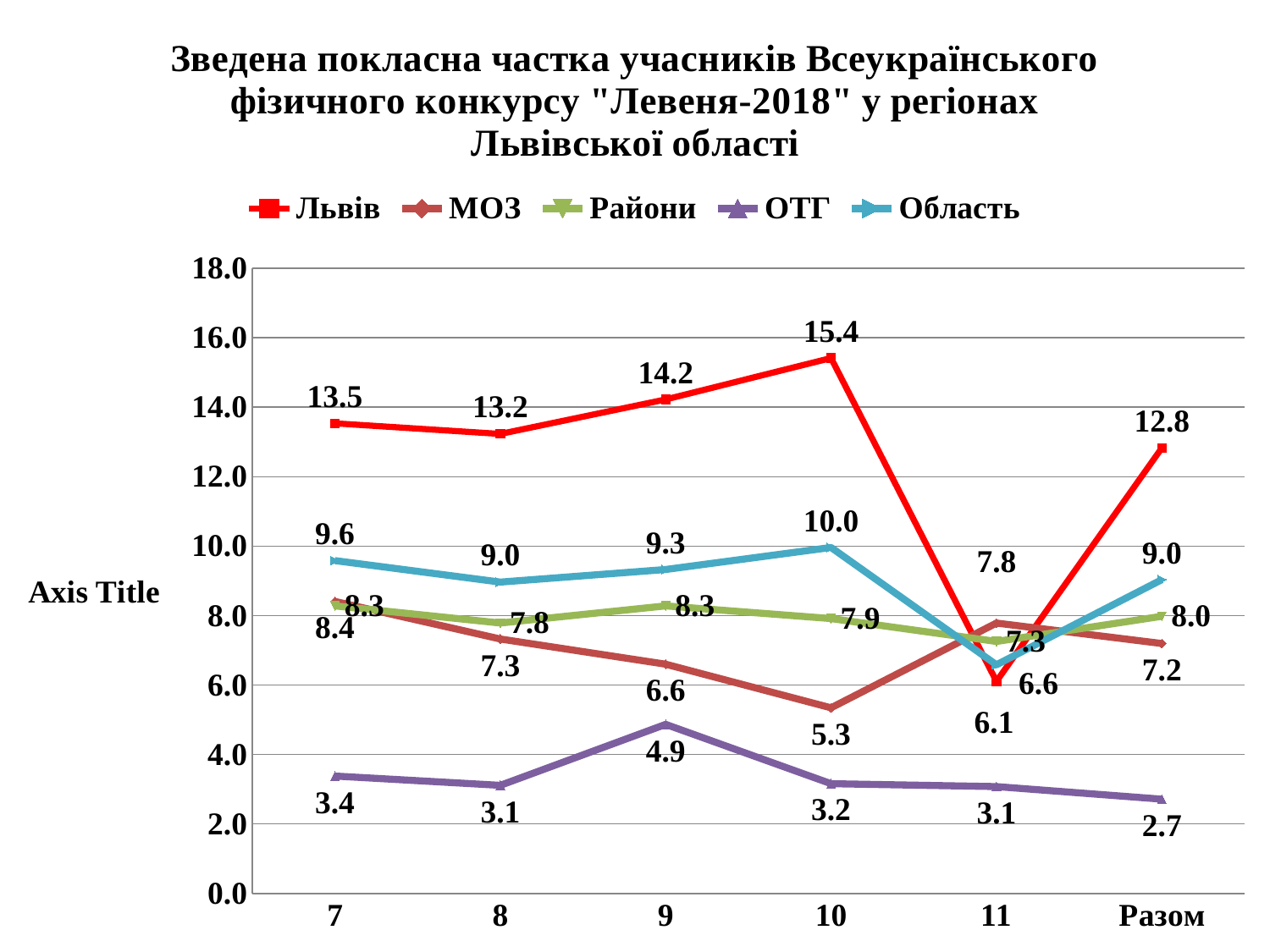
At category 10, which is larger: the value for Область or the value for Райони? Область How many series does the legend list? 5 At which category does the Львів series have its lowest value? 11 How many categories are shown on the x axis? 6 Do the ОТГ values rise or fall from category 9 to Разом? fall What is the value for МОЗ at category 10? 5.3 What is the difference between the Львів and ОТГ values at Разом? 10.1 What is the value for Львів at category 10? 15.4 What is the value for ОТГ at category 9? 4.9 What type of chart is shown on the slide? line chart At which category does the Львів series reach its highest value? 10 What is the value for Область at category 7? 9.6